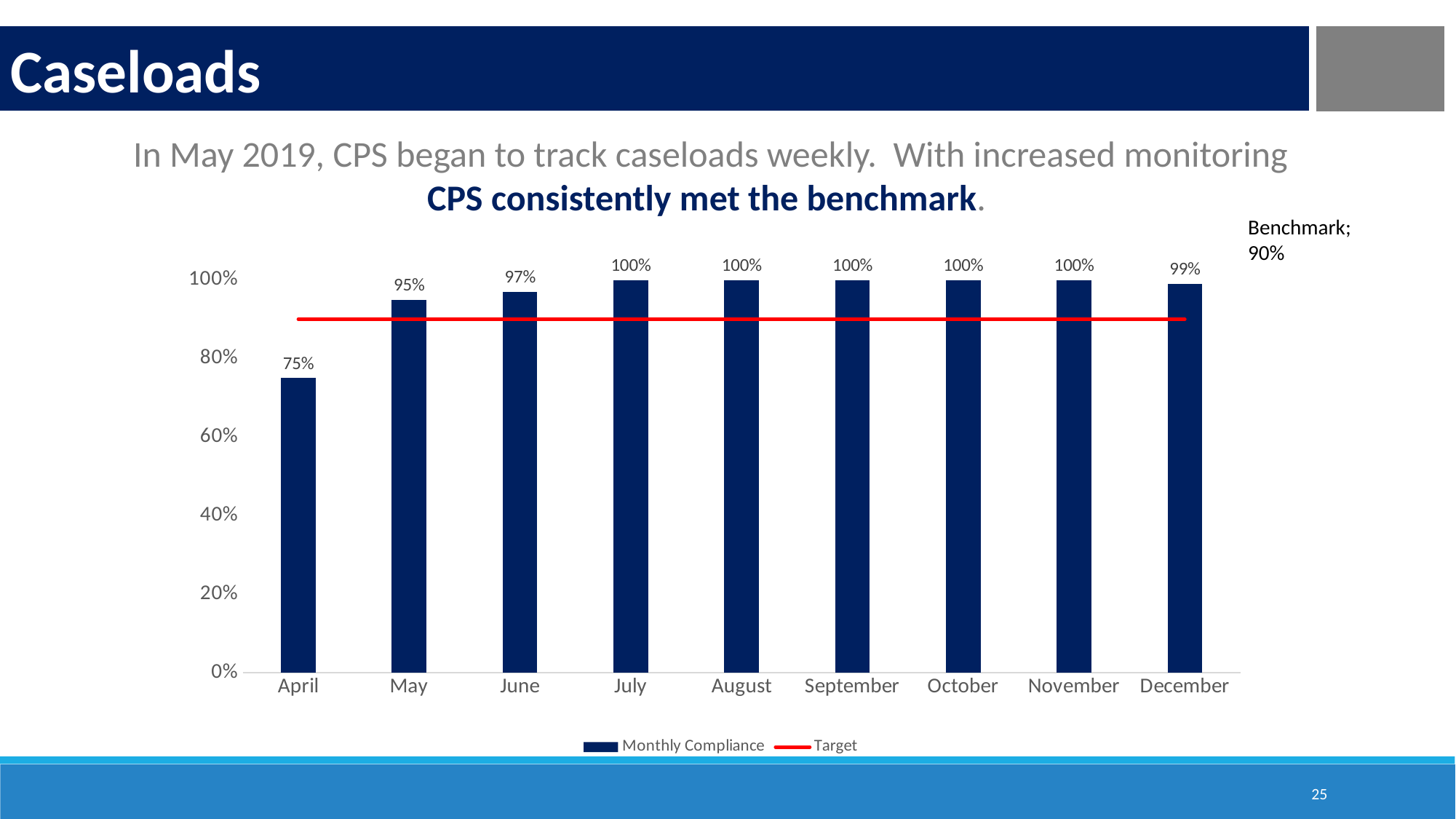
What is the Monthly Compliance value for May? 95% What is the difference between the Monthly Compliance values for June and April? 22% Which is larger, the Monthly Compliance value for May or for June? June What is the Monthly Compliance value for December? 99% What kind of chart is shown on the slide? bar chart How many series does the legend list? 2 Is the Monthly Compliance value for April greater or less than 80%? less What benchmark value does the red Target line represent? 90% What is the Monthly Compliance value for April? 75% Which month has the lowest Monthly Compliance value? April How many months are shown on the x axis? 9 Do the Monthly Compliance values rise or fall from April to July? rise